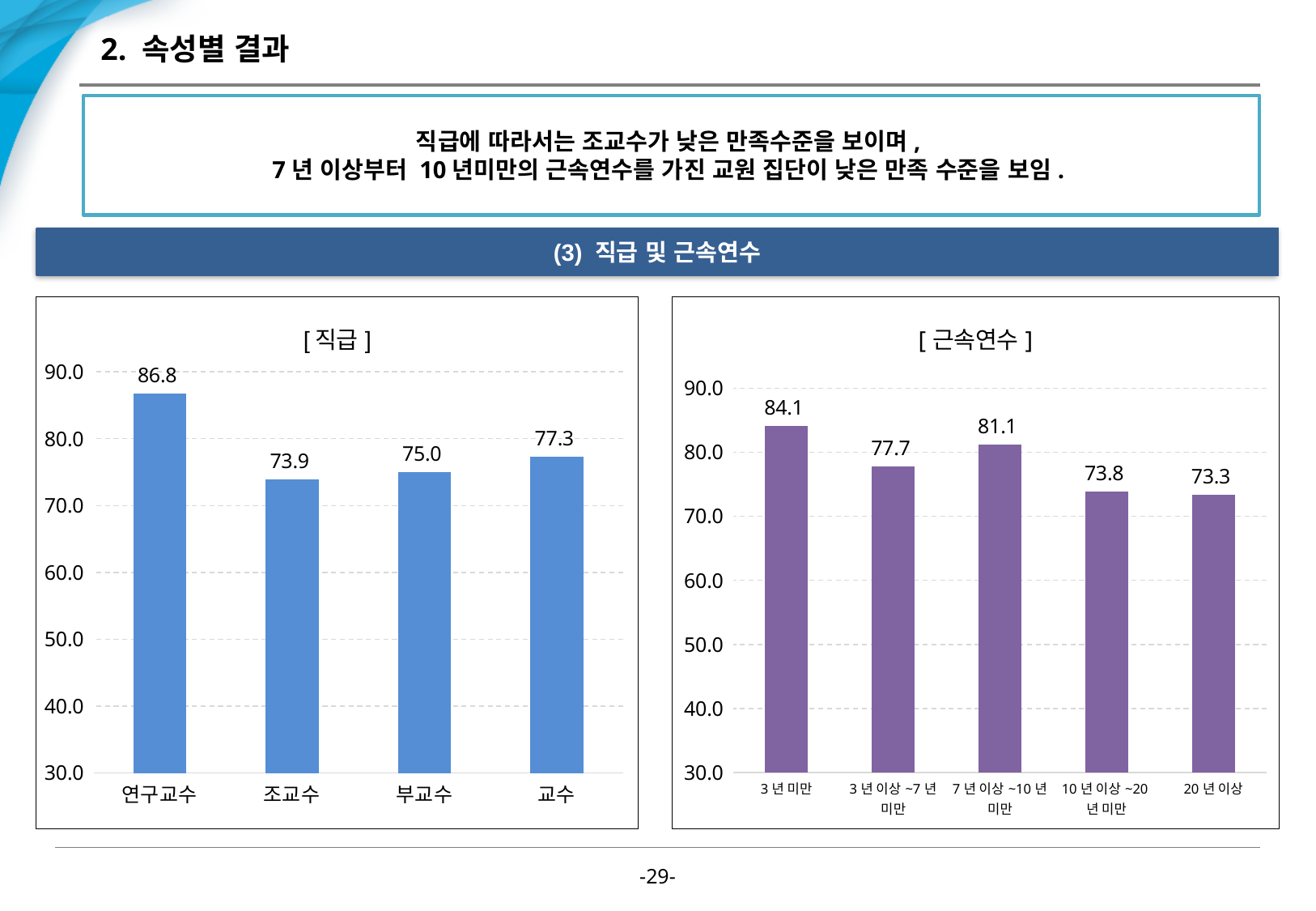
In the [근속연수] chart, how many categories are shown? 5 In the [직급] chart, which is larger, the value for 부교수 or the value for 교수? 교수 In the [근속연수] chart, what is the value for 3 년 미만? 84.1 In the [직급] chart, what is the value for 연구교수? 86.8 In the [근속연수] chart, what is the difference between the values for 3 년 미만 and 20 년 이상? 10.8 In the [직급] chart, which category has the lowest value? 조교수 What type of chart is the [직급] chart? Bar chart In the [직급] chart, how many categories are shown? 4 In the [근속연수] chart, which category has the lowest value? 20 년 이상 In the [직급] chart, what is the difference between the values for 연구교수 and 조교수? 12.9 In the [근속연수] chart, what is the value for 7 년 이상 ~10 년 미만? 81.1 In the [근속연수] chart, which category has the highest value? 3 년 미만